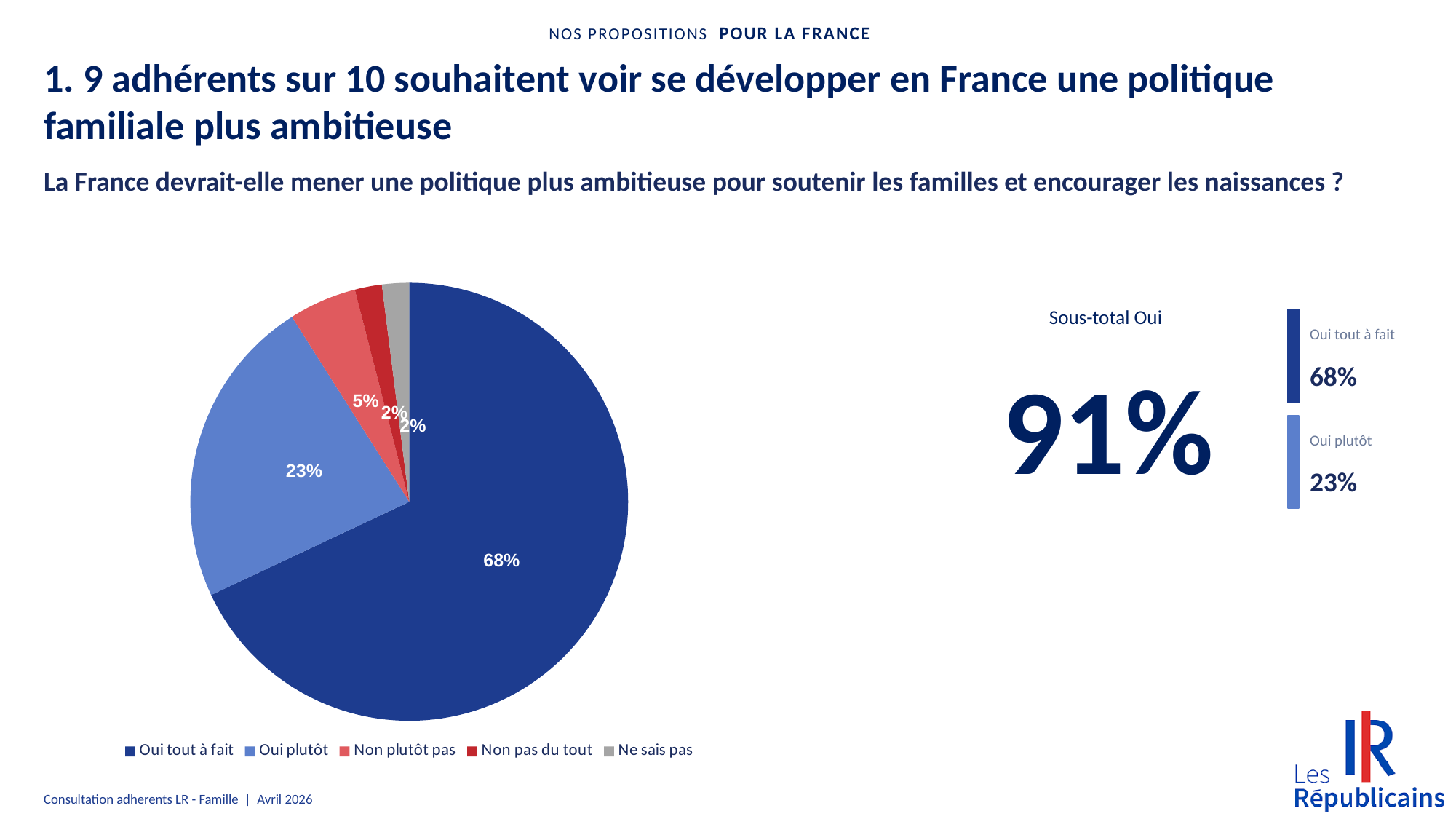
How many categories does the pie chart have? 5 What kind of chart is shown on the slide? Pie chart What is the combined share of "Oui tout à fait" and "Oui plutôt" (Sous-total Oui)? 91% What colour is the "Non pas du tout" slice? Dark red What share of the pie does "Ne sais pas" represent? 2% Which category has the largest slice of the pie? Oui tout à fait What share of the pie does "Oui plutôt" represent? 23% What share of the pie does "Oui tout à fait" represent? 68% What share of the pie does "Non plutôt pas" represent? 5% What is the difference between the "Oui tout à fait" and "Oui plutôt" slices? 45 percentage points What is the combined share of "Non plutôt pas" and "Non pas du tout"? 7% Which is larger, the "Oui plutôt" slice or the "Non plutôt pas" slice? Oui plutôt